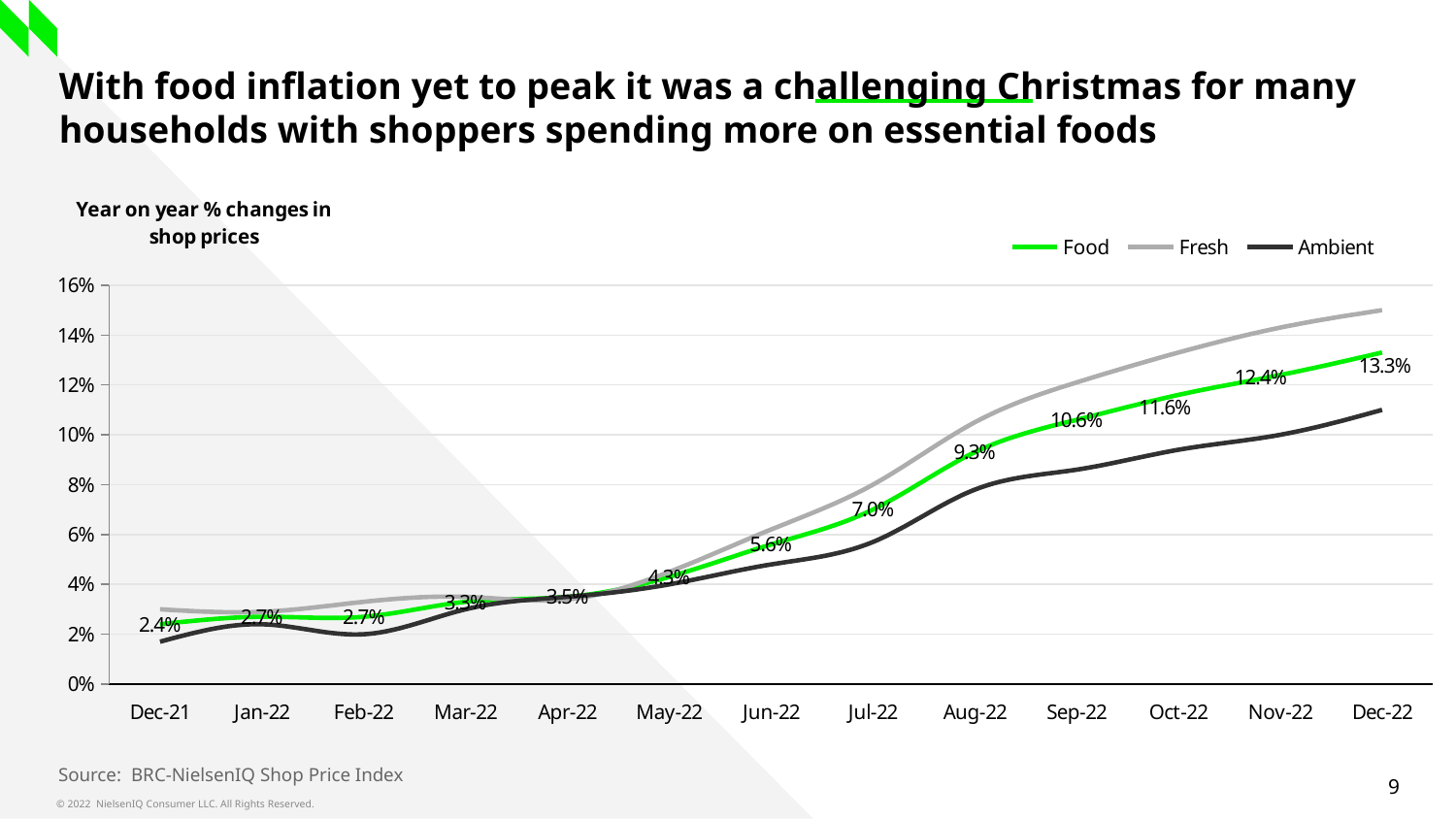
Is the Ambient value for Dec-22 greater or less than 8%? greater What is the Food value for Dec-21? 2.4% What is the difference between the Food values for Sep-22 and Aug-22? 1.3% At Dec-22, which series is larger, Fresh or Ambient? Fresh What is the difference between the Food values for Dec-22 and Dec-21? 10.9% What is the Food value for Jul-22? 7.0% How many series does the legend list? 3 What is the Food value for Dec-22? 13.3% What kind of chart is shown on the slide? Line chart Is the Fresh value for Dec-22 greater or less than 14%? greater In which month is the Food series lowest? Dec-21 In which month is the Food series highest? Dec-22